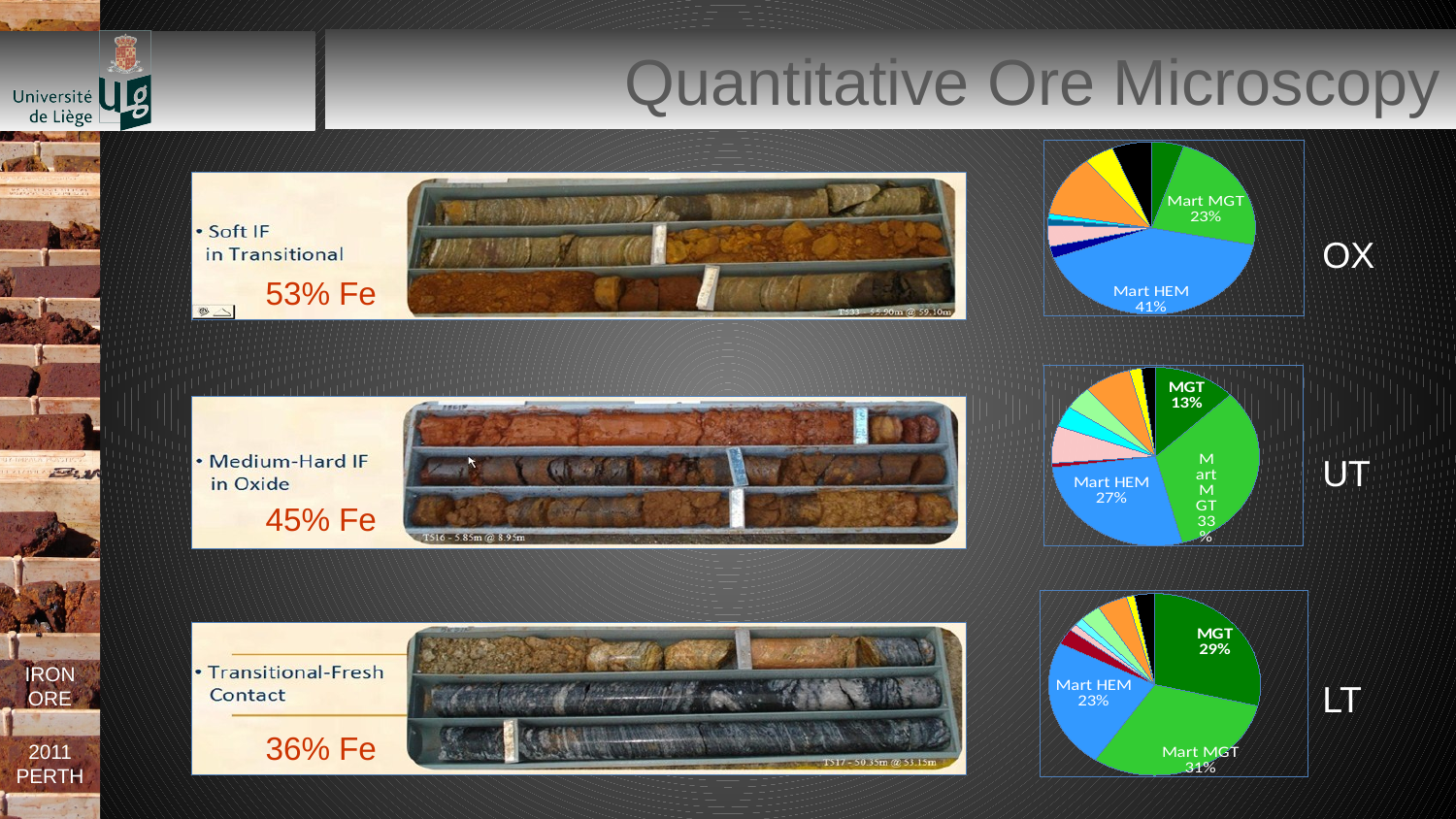
In the OX pie chart, what share is labelled for Mart HEM? 41% What type of chart is used for the OX, UT and LT mineral compositions? Pie chart In the UT pie chart, what share is labelled for MGT? 13% In the OX pie chart, which labelled slice is the largest? Mart HEM In the OX pie chart, what share is labelled for Mart MGT? 23% In the LT pie chart, what share is labelled for MGT? 29% In the UT pie chart, what share is labelled for Mart HEM? 27% In the OX pie chart, what is the difference between the Mart HEM share and the Mart MGT share? 18% In the UT pie chart, which labelled slice is the largest? Mart MGT In the LT pie chart, what share is labelled for Mart MGT? 31% In the LT pie chart, which is larger, the Mart MGT share or the MGT share? Mart MGT In the LT pie chart, what share is labelled for Mart HEM? 23%